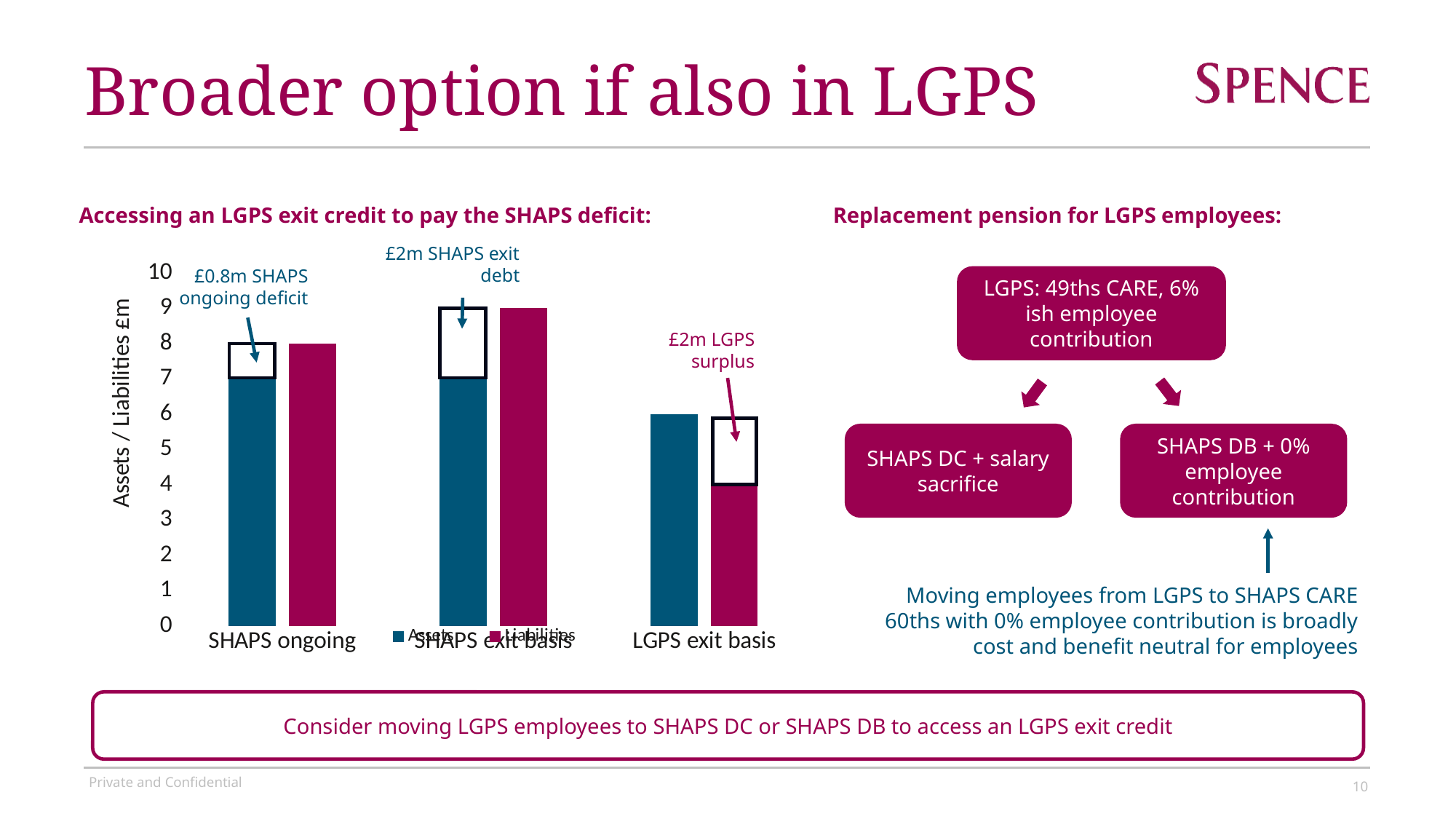
For LGPS exit basis, which is larger, Assets or Liabilities? Assets What kind of chart is shown on the slide? bar chart Is the Assets value for LGPS exit basis greater or less than 5? greater What are the two series named in the chart legend? Assets and Liabilities What is the Assets value for SHAPS ongoing? 7 What is the Liabilities value for LGPS exit basis? 4 Which category has the highest Liabilities value? SHAPS exit basis What is the label on the vertical axis of the chart? Assets / Liabilities £m How many categories are shown on the x axis of the chart? 3 What is the Liabilities value for SHAPS exit basis? 9 Which category has the lowest Liabilities value? LGPS exit basis How many series does the chart legend list? 2